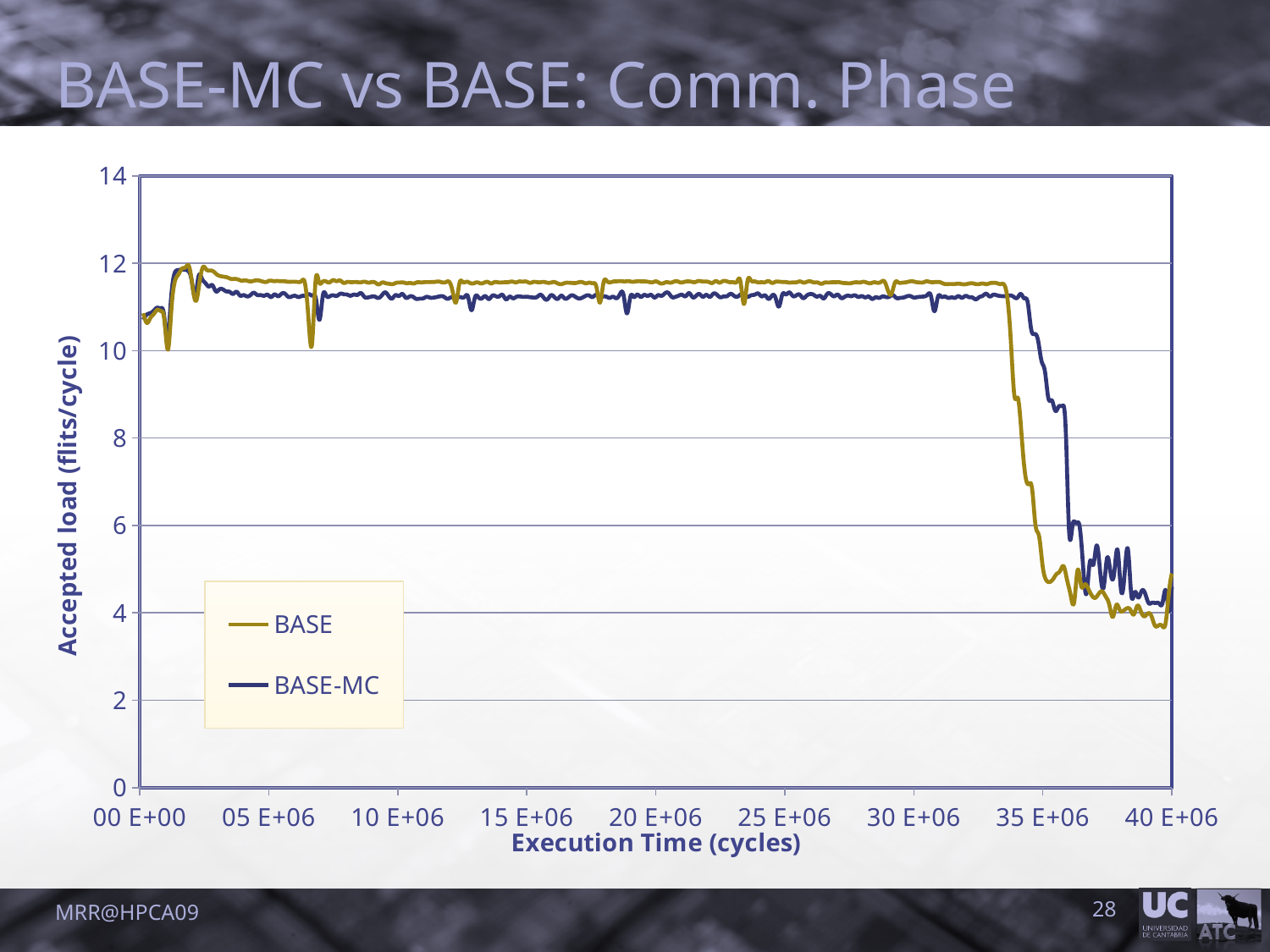
Is the value for BASE at 20 E+06 cycles greater or less than 10? greater What kind of chart is shown on the slide? line chart Is the value for BASE-MC at 38 E+06 cycles greater or less than 8? less Is the value for BASE-MC at 30 E+06 cycles greater or less than 10? greater Between 34 E+06 and 40 E+06 cycles, does the BASE line rise or fall? fall At 36 E+06 cycles, which series has the higher accepted load, BASE or BASE-MC? BASE-MC Between 5 E+06 and 30 E+06 cycles, does the BASE-MC line stay roughly flat, rise, or fall? roughly flat How many tick labels are shown on the x axis? 9 What is the label of the vertical axis? Accepted load (flits/cycle) How many series does the legend list? 2 What is the title of the chart on the slide? BASE-MC vs BASE: Comm. Phase